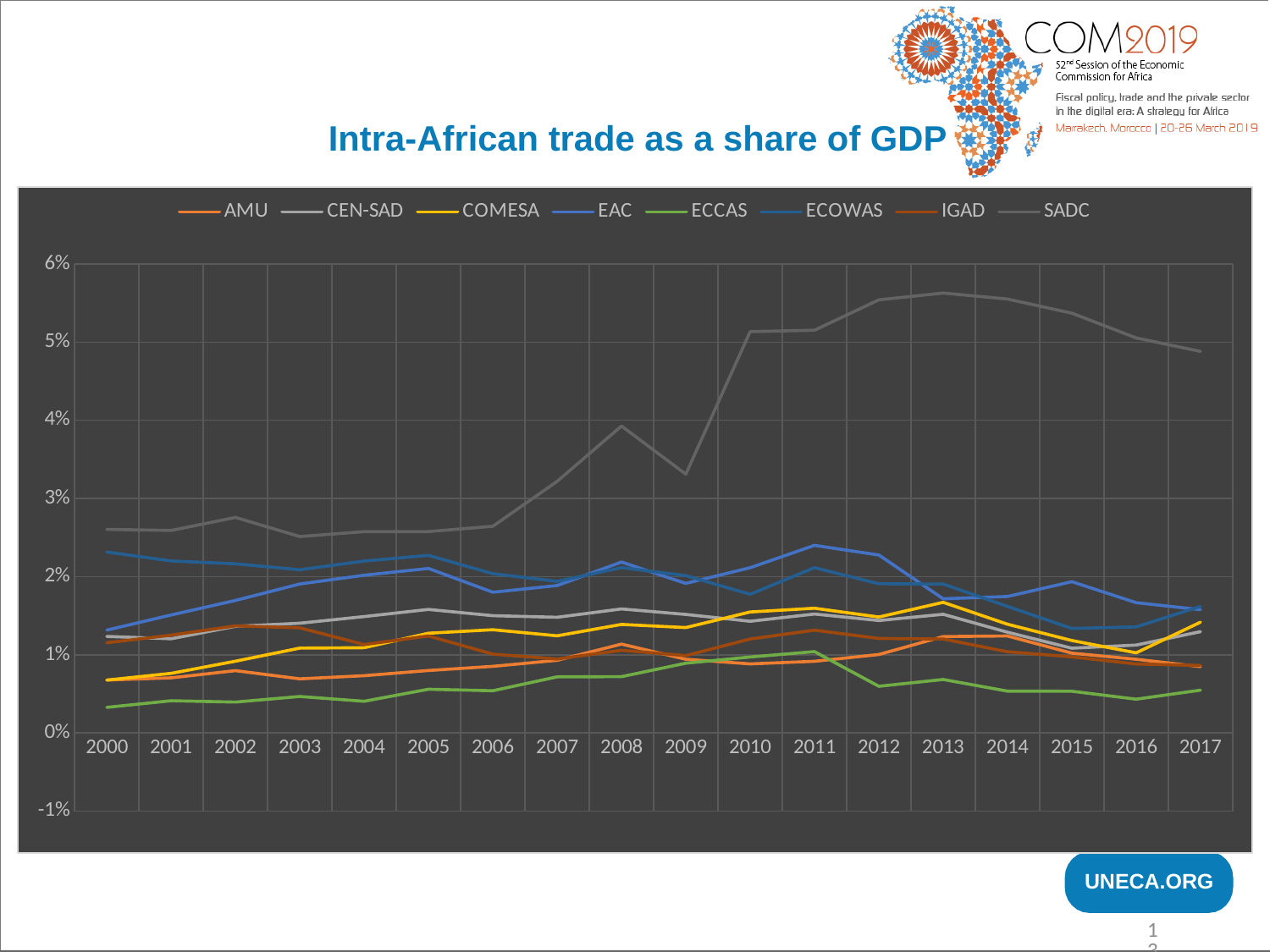
Which series has the lowest value in 2000? ECCAS Is the value for SADC in 2013 greater or less than 5%? greater Is the value for SADC in 2000 greater or less than 3%? less What kind of chart is shown on the slide? line chart Which series is listed first in the legend? AMU Is the value for ECCAS in 2017 greater or less than 1%? less How many years are shown along the x axis? 18 Which is larger in 2010, the value for SADC or the value for ECCAS? SADC How many series does the legend list? 8 What is the title of the chart? Intra-African trade as a share of GDP Which series has the highest value in 2017? SADC Does the SADC line rise or fall from 2013 to 2017? fall